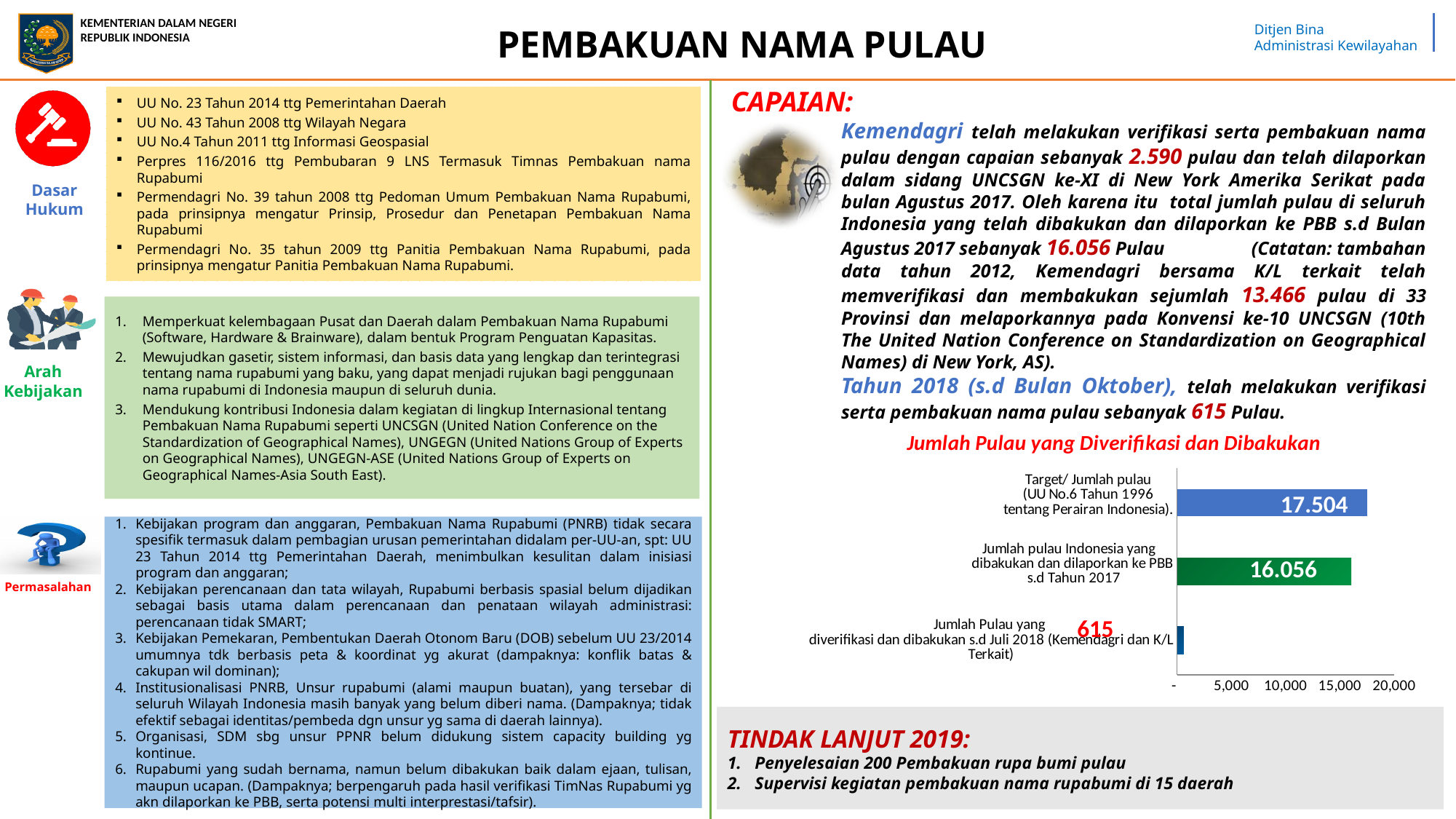
Is the value for "Jumlah pulau Indonesia yang dibakukan dan dilaporkan ke PBB s.d Tahun 2017" greater or less than 15,000? greater What is the difference between the value for islands reported to PBB up to 2017 and the value for islands verified up to Juli 2018? 15.441 What is the difference between the target value (17.504) and the number of islands reported to PBB up to 2017 (16.056)? 1.448 What is the value for "Target/ Jumlah pulau (UU No.6 Tahun 1996 tentang Perairan Indonesia)" in the chart? 17.504 Which category has the lowest value in the chart? Jumlah Pulau yang diverifikasi dan dibakukan s.d Juli 2018 (Kemendagri dan K/L Terkait) What type of chart is shown under the title "Jumlah Pulau yang Diverifikasi dan Dibakukan"? bar chart What is the value for "Jumlah pulau Indonesia yang dibakukan dan dilaporkan ke PBB s.d Tahun 2017" in the chart? 16.056 How many categories (bars) are shown in the chart? 3 Which is larger: the value for "Jumlah pulau Indonesia yang dibakukan dan dilaporkan ke PBB s.d Tahun 2017" or the value for "Jumlah Pulau yang diverifikasi dan dibakukan s.d Juli 2018"? Jumlah pulau Indonesia yang dibakukan dan dilaporkan ke PBB s.d Tahun 2017 Which category has the highest value in the chart? Target/ Jumlah pulau (UU No.6 Tahun 1996 tentang Perairan Indonesia) What is the title of the chart on the slide? Jumlah Pulau yang Diverifikasi dan Dibakukan What is the value for "Jumlah Pulau yang diverifikasi dan dibakukan s.d Juli 2018 (Kemendagri dan K/L Terkait)" in the chart? 615